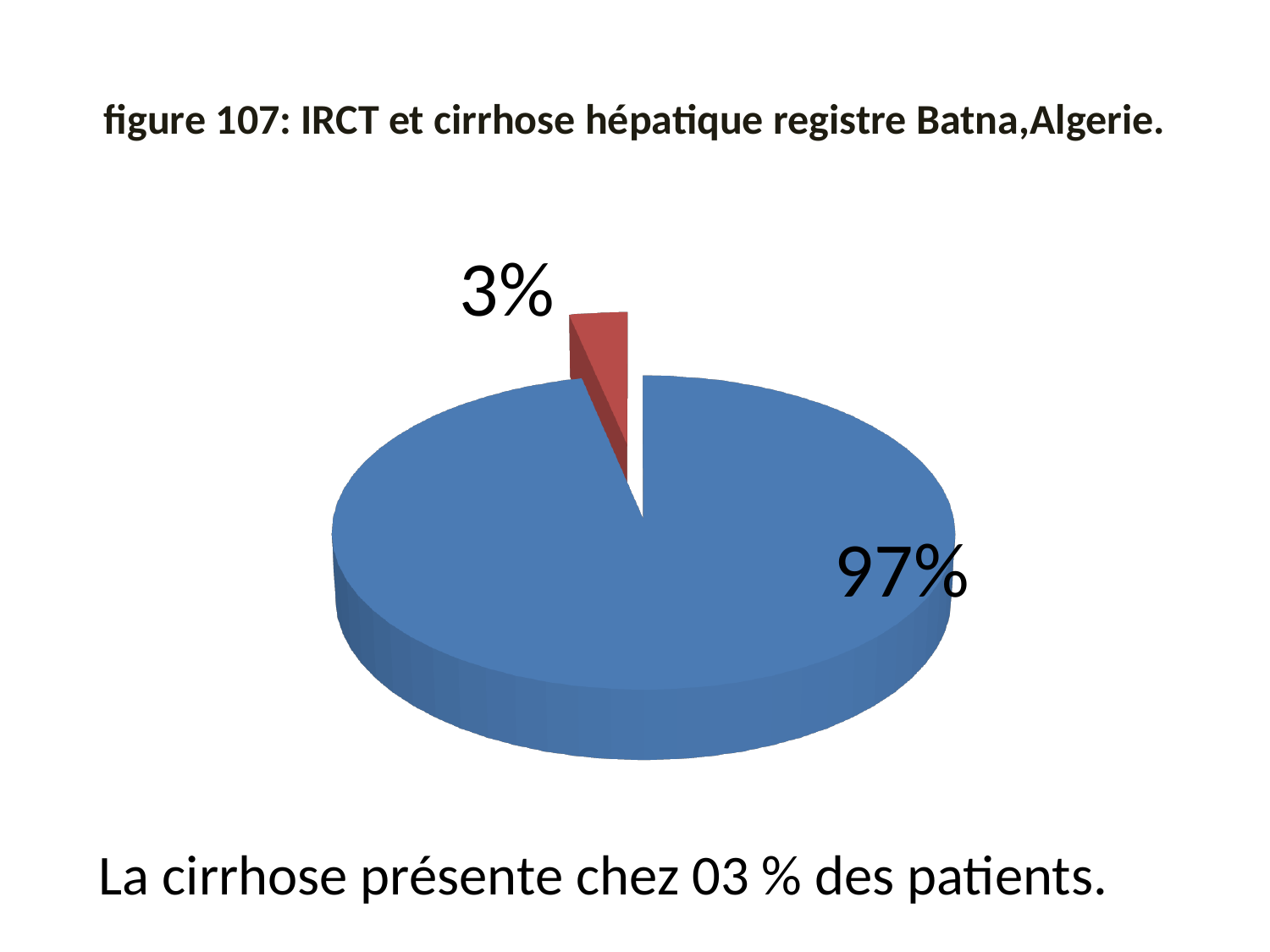
What share of the pie does the red slice represent? 3% What kind of chart is shown on the slide? pie chart Is the blue slice larger or smaller than the red slice? larger Which slice of the pie chart is the smallest? the red slice (3%) Which slice of the pie chart is the largest? the blue slice (97%) What percentage is shown for the red slice of the pie chart? 3% What percentage is shown for the blue slice of the pie chart? 97% How many slices does the pie chart have? 2 What is the title of the chart? figure 107: IRCT et cirrhose hépatique registre Batna,Algerie. What is the difference in percentage points between the blue slice and the red slice? 94 Which slice of the pie chart is pulled out (exploded) from the rest? the red 3% slice According to the slide, what percentage of patients have cirrhosis? 03 %